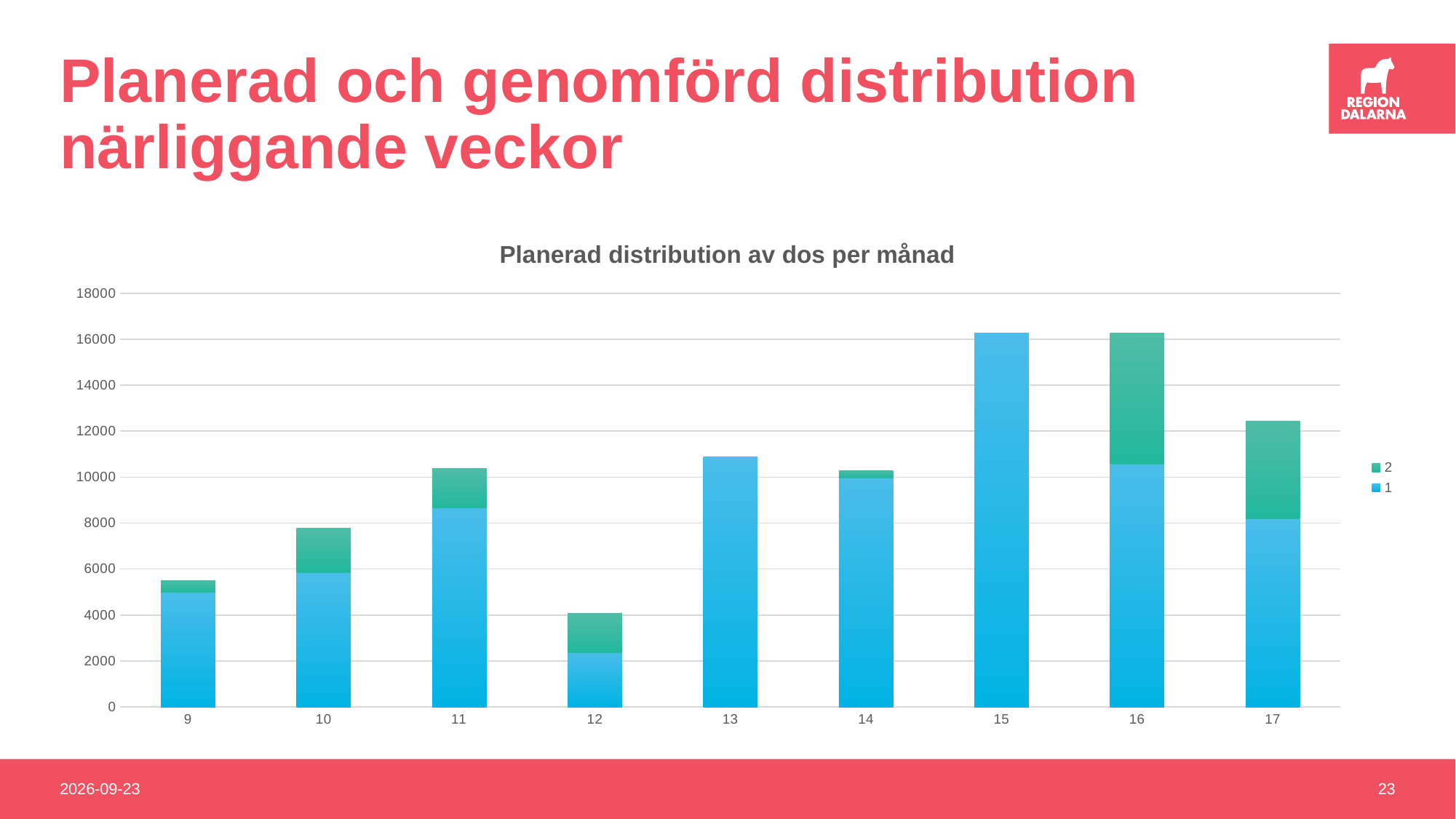
Which legend entry is shown in green? 2 Is the total bar for category 15 greater or less than 16000? greater Is the total bar for category 9 greater or less than 6000? less How many series does the legend list? 2 Is the value of series 1 for category 16 greater or less than 10000? greater What kind of chart is shown on the slide? bar chart What is the title of the chart? Planerad distribution av dos per månad Which category has the lowest total bar? 12 How many categories are shown on the x axis? 9 Which has the larger total bar, category 13 or category 9? 13